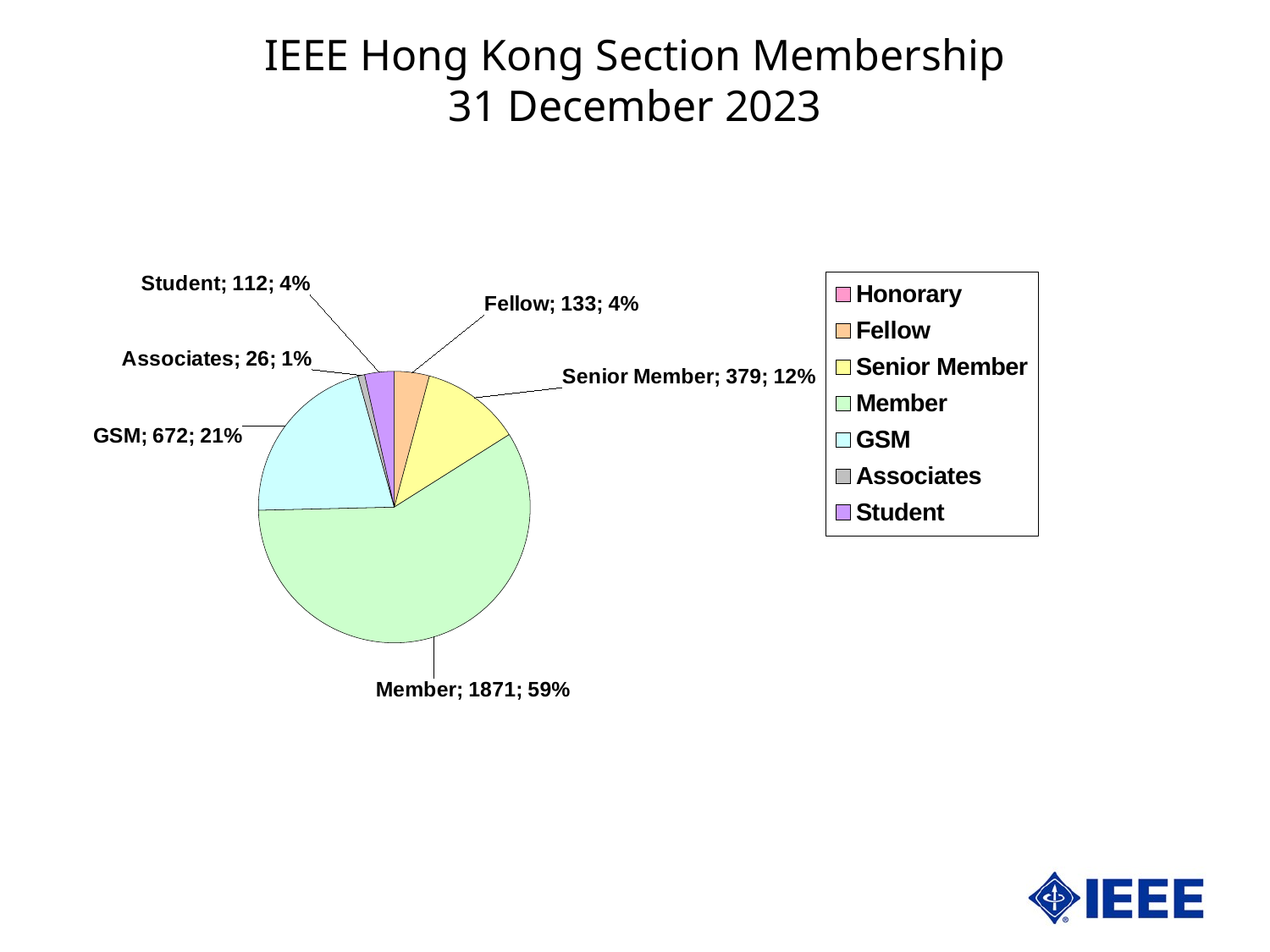
What is the count for Senior Member? 379 What is the difference between the Member count and the GSM count? 1199 How many members are in the Member category? 1871 What percentage share of the pie does the Member slice represent? 59% What kind of chart is shown on the slide? Pie chart What percentage share of the pie does GSM represent? 21% Which is larger, the GSM count or the Senior Member count? GSM How many categories does the legend list? 7 What is the count for Fellow? 133 Of the slices with data labels, which category has the smallest count? Associates What is the count for GSM? 672 Which category has the largest slice of the pie? Member